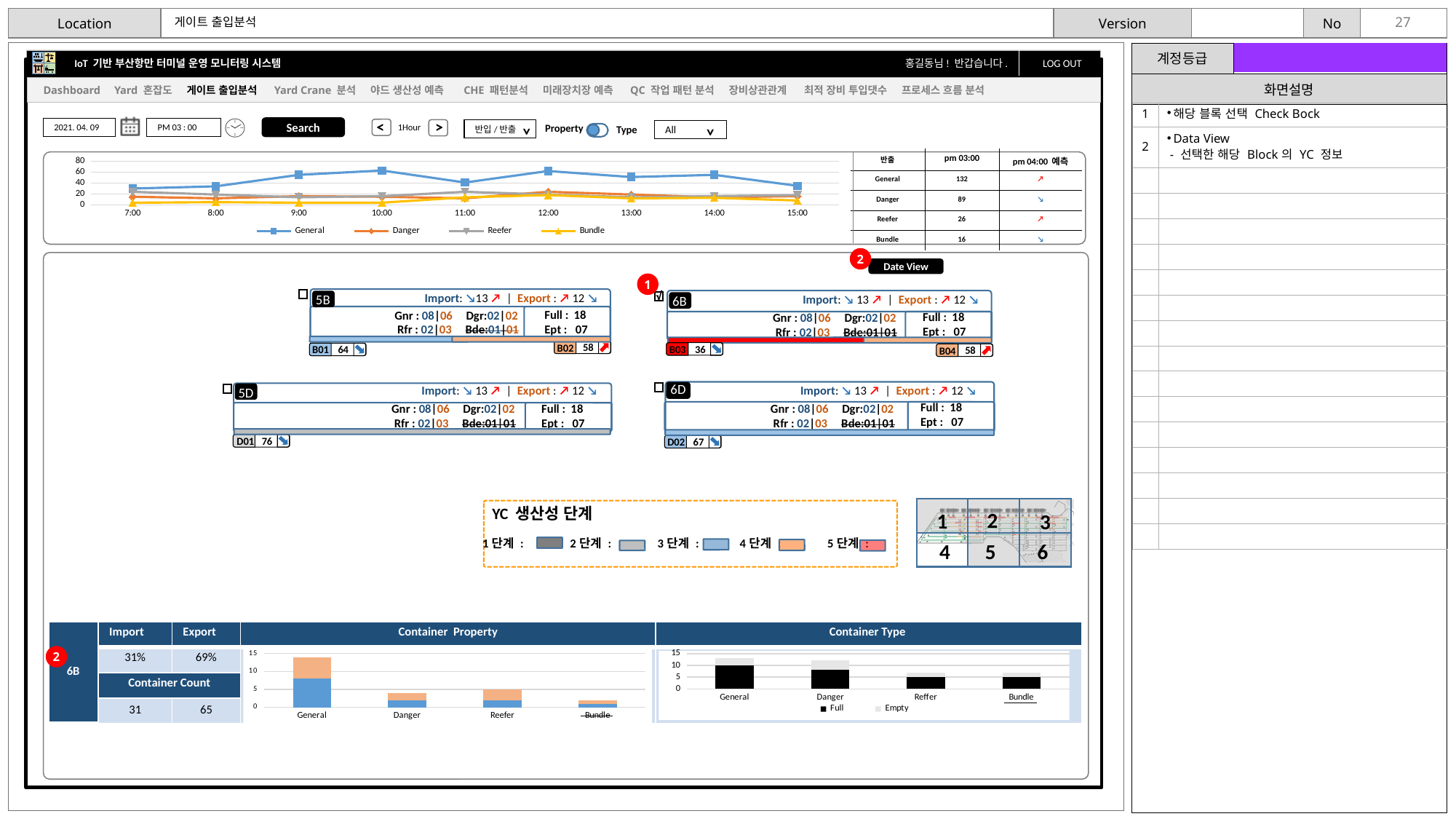
In the top line chart, how many series does the legend list? 4 In the Container Type chart, is the total for Reffer greater or less than 10? less In the Container Property chart, which category has the tallest bar? General In the top line chart, which series has the highest values across the time points? General In the top line chart, is the value for General at 10:00 greater or less than 40? greater What kind of chart is the chart at the top of the slide showing values from 7:00 to 15:00? line chart In the Container Type chart, how many series does the legend list? 2 In the top line chart, how many time points are shown on the x axis? 9 In the Container Property chart, which category has the shortest bar? Bundle In the Container Property chart, is the total for General greater or less than 10? greater What kind of chart is the Container Property chart? bar chart